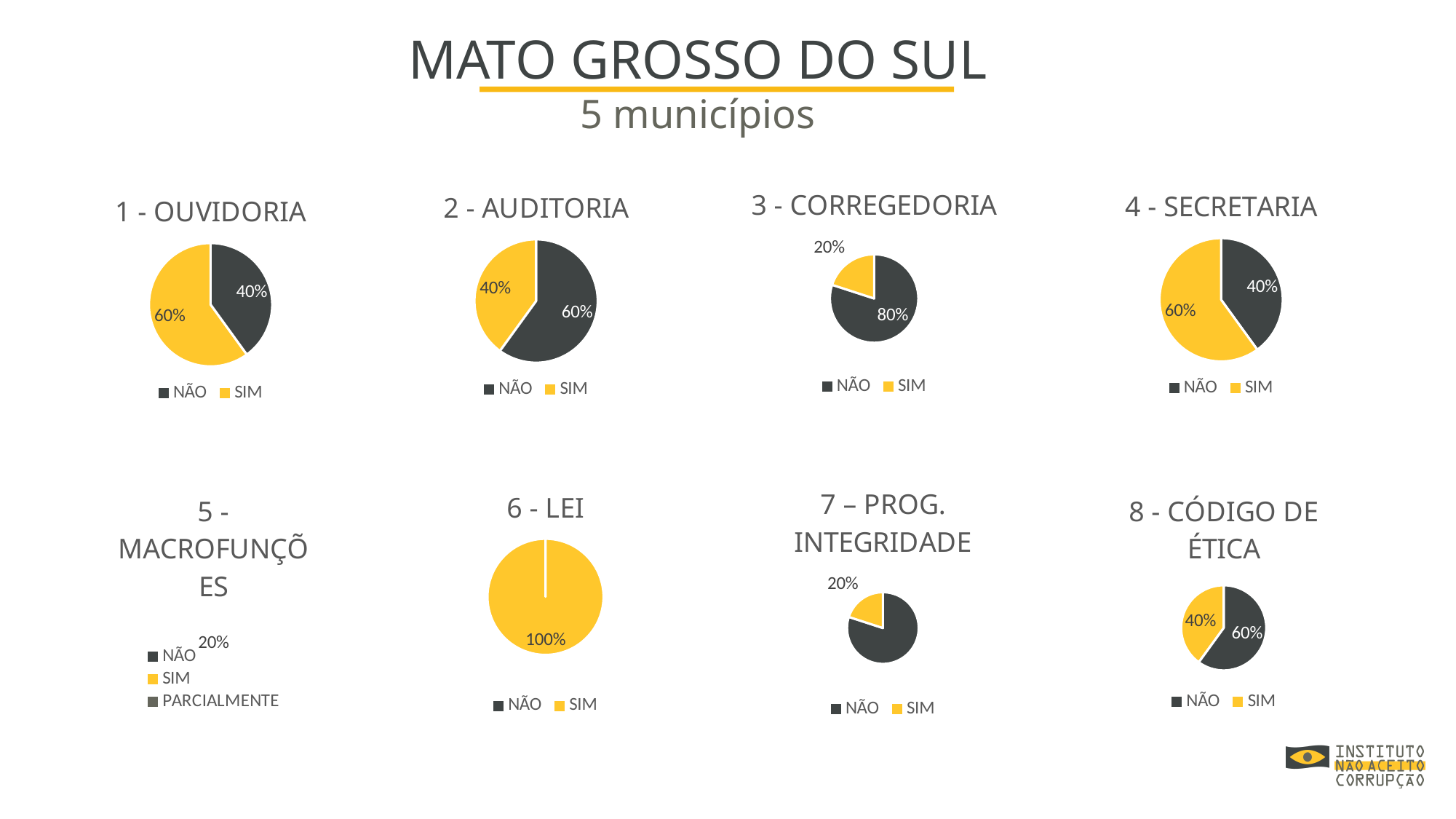
In the "6 - LEI" chart, what percentage is shown for SIM? 100% In the "7 – PROG. INTEGRIDADE" chart, what percentage is shown for SIM? 20% In the "3 - CORREGEDORIA" chart, which category has the largest slice? NÃO In the "4 - SECRETARIA" chart, what is the difference between the SIM and NÃO percentages? 20% In the "8 - CÓDIGO DE ÉTICA" chart, which is larger, NÃO or SIM? NÃO In the "1 - OUVIDORIA" chart, what share of the pie is SIM? 60% In the "2 - AUDITORIA" chart, what percentage is shown for NÃO? 60% In the "1 - OUVIDORIA" chart, which colour represents SIM? Yellow How many entries does the legend of the "5 - MACROFUNÇÕES" chart list? 3 In the "3 - CORREGEDORIA" chart, what percentage is shown for SIM? 20% In the "8 - CÓDIGO DE ÉTICA" chart, what percentage is shown for SIM? 40% What type of chart is used for "2 - AUDITORIA"? Pie chart